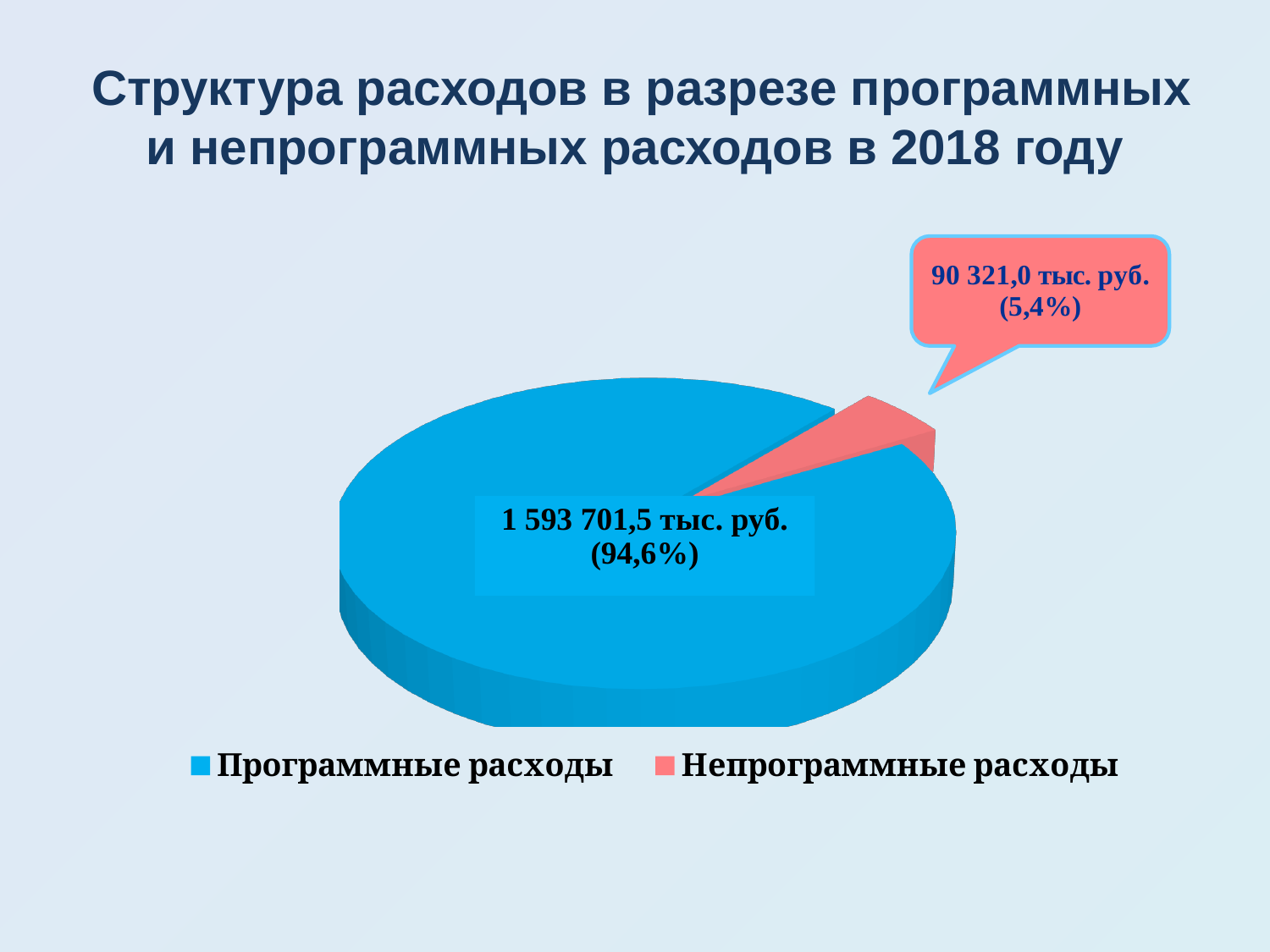
What is the value for Программные расходы? 1 593 701,5 тыс. руб. What is the difference in percentage share between Программные расходы and Непрограммные расходы? 89,2% What kind of chart is shown on the slide? pie chart What is the value for Непрограммные расходы? 90 321,0 тыс. руб. Which category has the largest slice of the pie? Программные расходы Which category has the smallest slice of the pie? Непрограммные расходы What share of the pie does Непрограммные расходы represent? 5,4% How many entries does the legend list? 2 How many slices does the pie chart have? 2 What colour is the slice for Непрограммные расходы? red (pink) What share of the pie does Программные расходы represent? 94,6% Which is larger, Программные расходы or Непрограммные расходы? Программные расходы